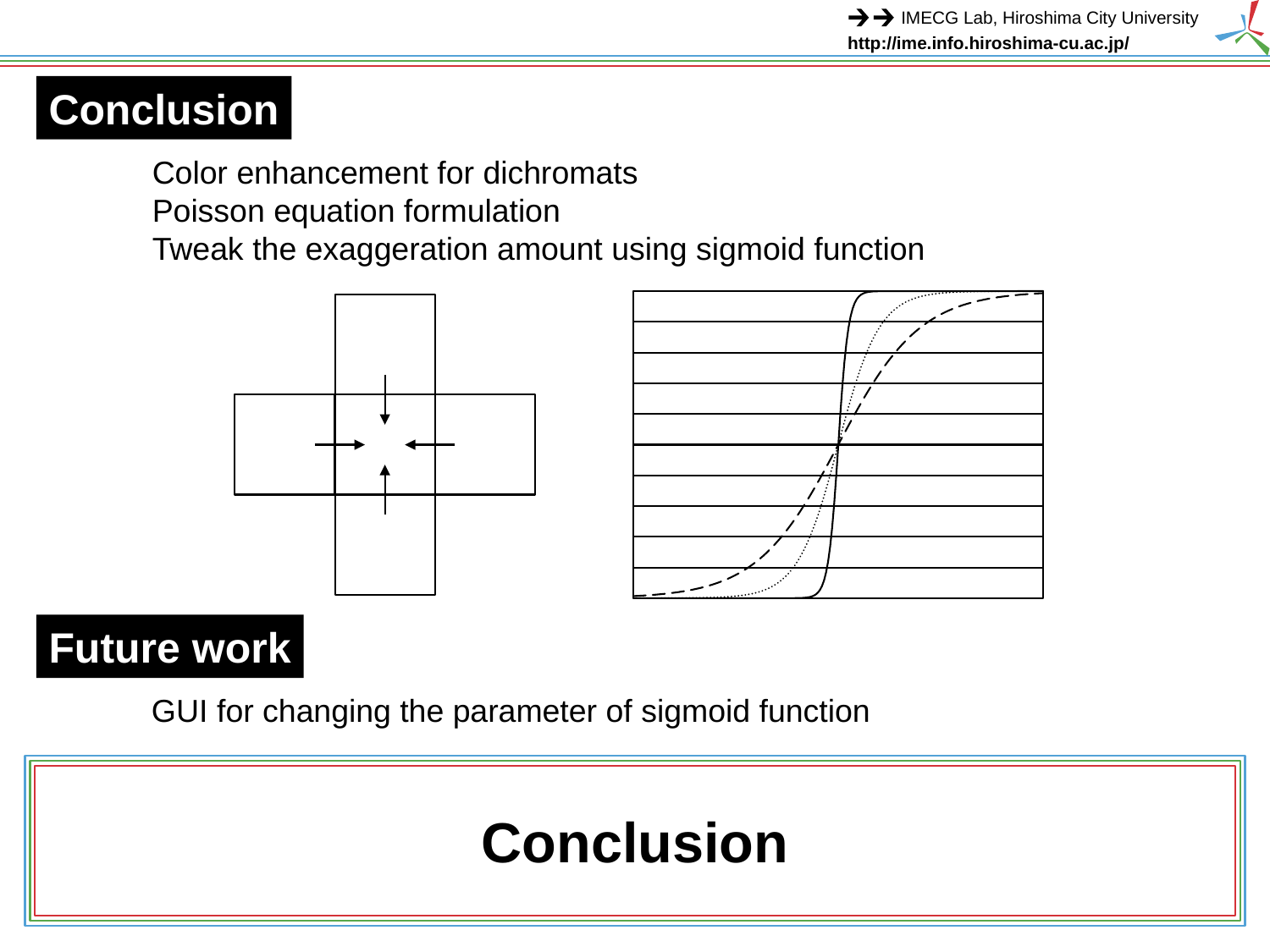
Do the curves in the chart on the right rise or fall from left to right along the x axis? rise In the chart on the right, which line style has the most gradual curve: solid, dotted or dashed? dashed In the chart on the right, which line style has the steepest curve at the center: solid, dotted or dashed? solid How many curves are plotted in the chart on the right? 3 What kind of chart is shown on the right side of the slide? line chart